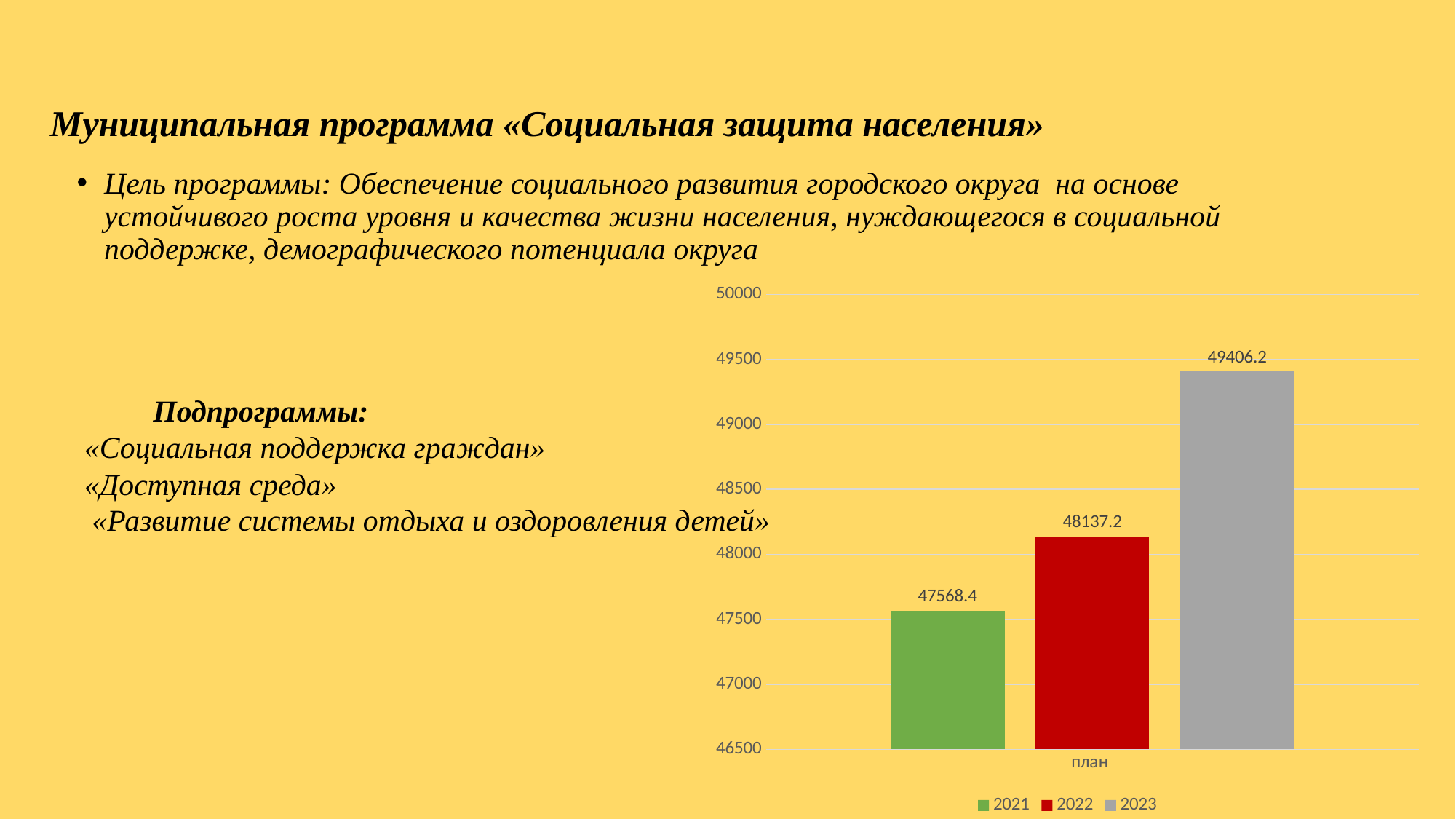
What kind of chart is shown on the slide? bar chart What is the category label shown on the x axis of the chart? план What is the value for 2021 in the chart? 47568.4 Which year has the highest value in the chart? 2023 What is the difference between the 2022 and 2021 values? 568.8 Which is larger, the value for 2021 or the value for 2023? 2023 What is the value for 2022 in the chart? 48137.2 Is the value for 2022 greater or less than 48000? greater What is the value for 2023 in the chart? 49406.2 What is the difference between the 2023 and 2022 values? 1269 Which year has the lowest value in the chart? 2021 How many series does the legend list? 3